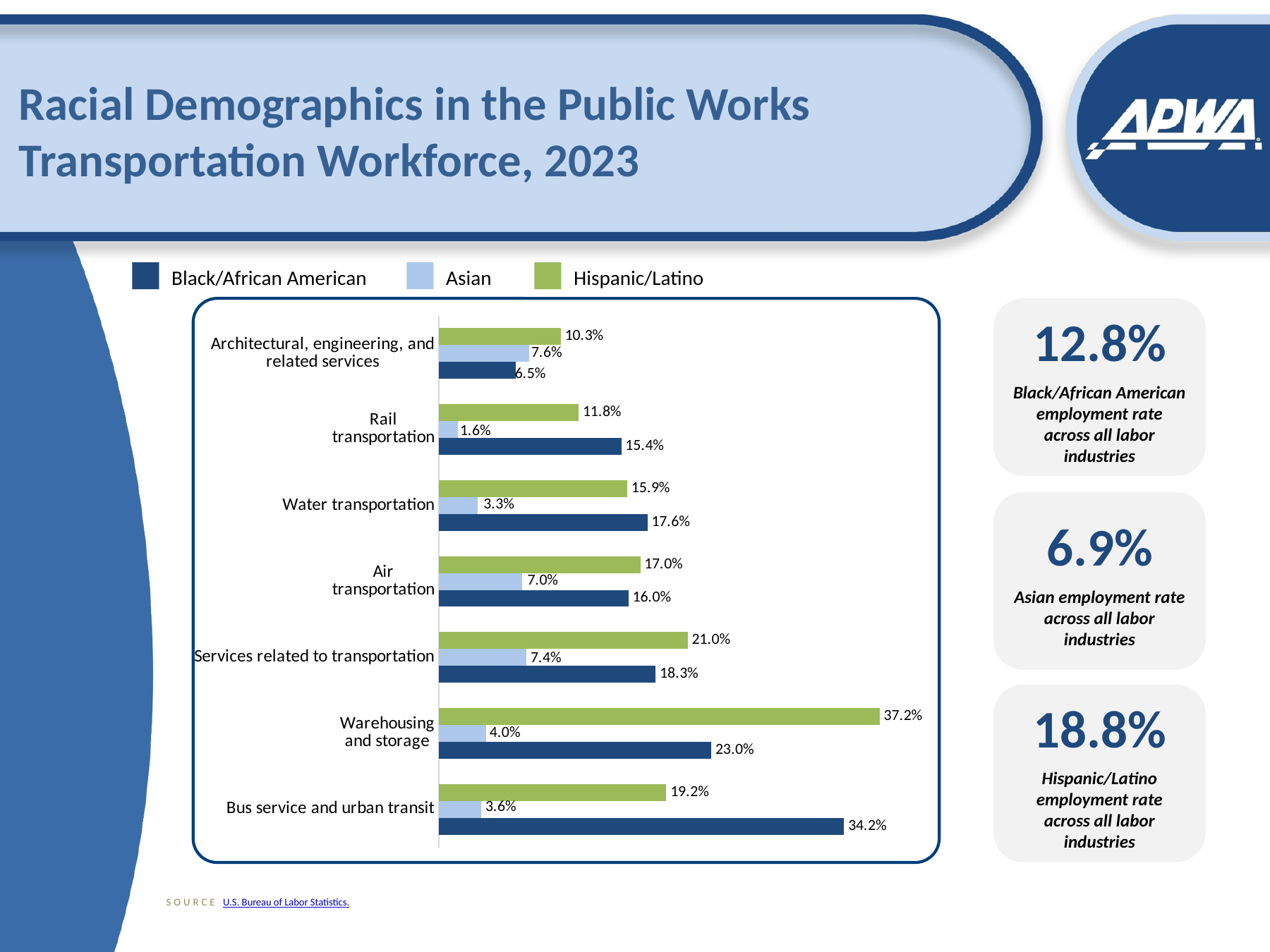
How many series does the legend list? 3 For Water transportation, which is larger: the Black/African American share or the Hispanic/Latino share? Black/African American How many industry categories are shown in the chart? 7 What is the Asian share for Rail transportation? 1.6% Which category has the lowest Asian share? Rail transportation What is the Black/African American share for Bus service and urban transit? 34.2% Which category has the highest Hispanic/Latino share? Warehousing and storage What is the difference between the Hispanic/Latino and Black/African American shares for Warehousing and storage? 14.2% What kind of chart is shown on the slide? Bar chart Which colour represents the Asian series in the chart? Light blue Which category has the lowest Black/African American share? Architectural, engineering, and related services What is the Hispanic/Latino share for Warehousing and storage? 37.2%